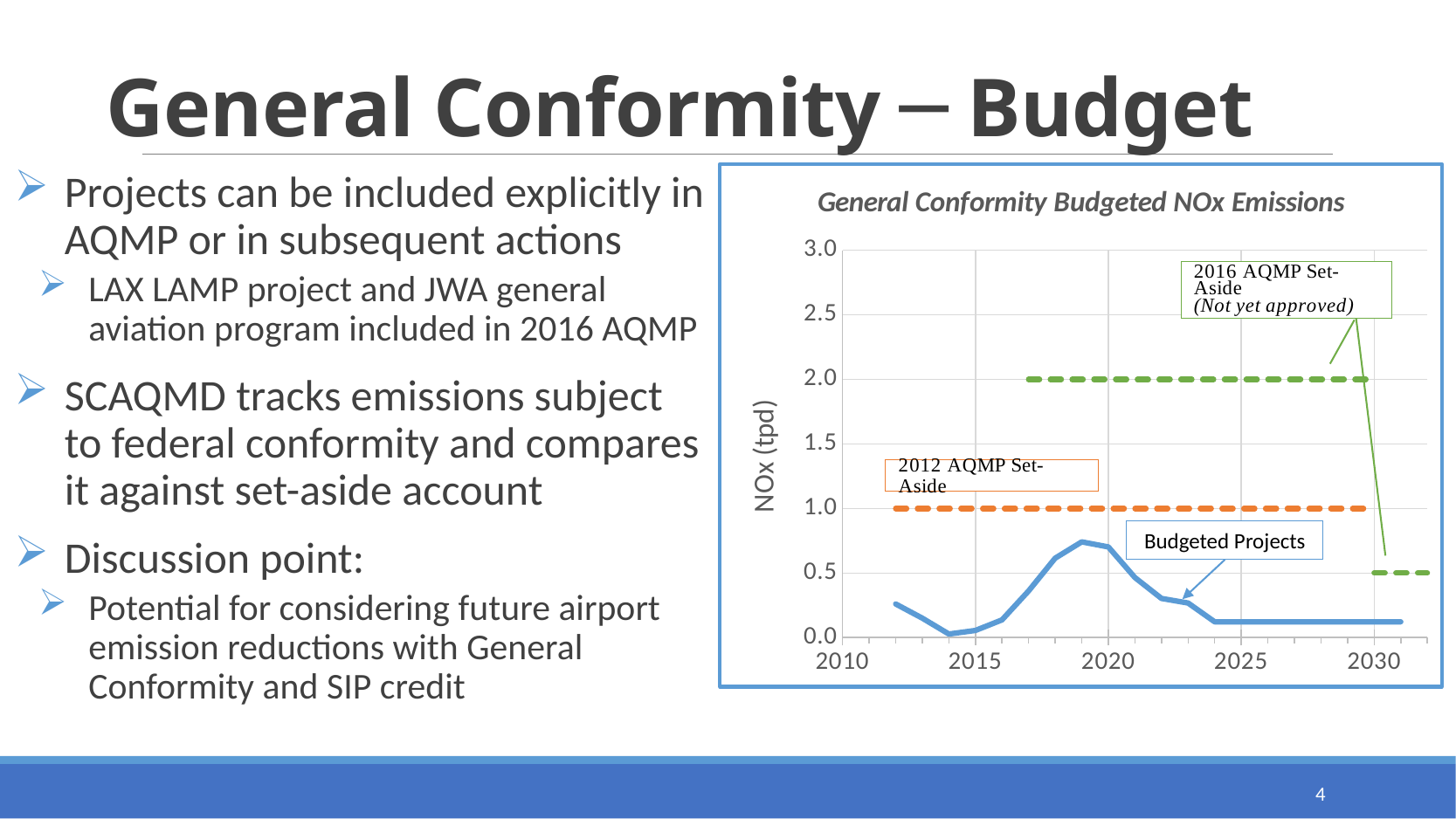
How many lines are plotted on the chart? 4 Is the value of the Budgeted Projects line in 2014 greater or less than 0.5? less What kind of chart is shown on the slide? line chart What is the label on the y axis of the chart? NOx (tpd) Is the peak value of the Budgeted Projects line around 2019 greater or less than 1.0? less Do the Budgeted Projects values rise or fall between 2019 and 2024? fall What is the value of the 2016 AQMP Set-Aside line between 2017 and 2030 in tpd? 2.0 What is the difference between the 2016 AQMP Set-Aside (before 2030) and the 2012 AQMP Set-Aside values? 1.0 What is the value of the 2012 AQMP Set-Aside line in tpd? 1.0 Which set-aside line is higher before 2030, the 2012 AQMP Set-Aside or the 2016 AQMP Set-Aside? 2016 AQMP Set-Aside What value does the 2016 AQMP Set-Aside line drop to after 2030? 0.5 What is the title of the chart? General Conformity Budgeted NOx Emissions